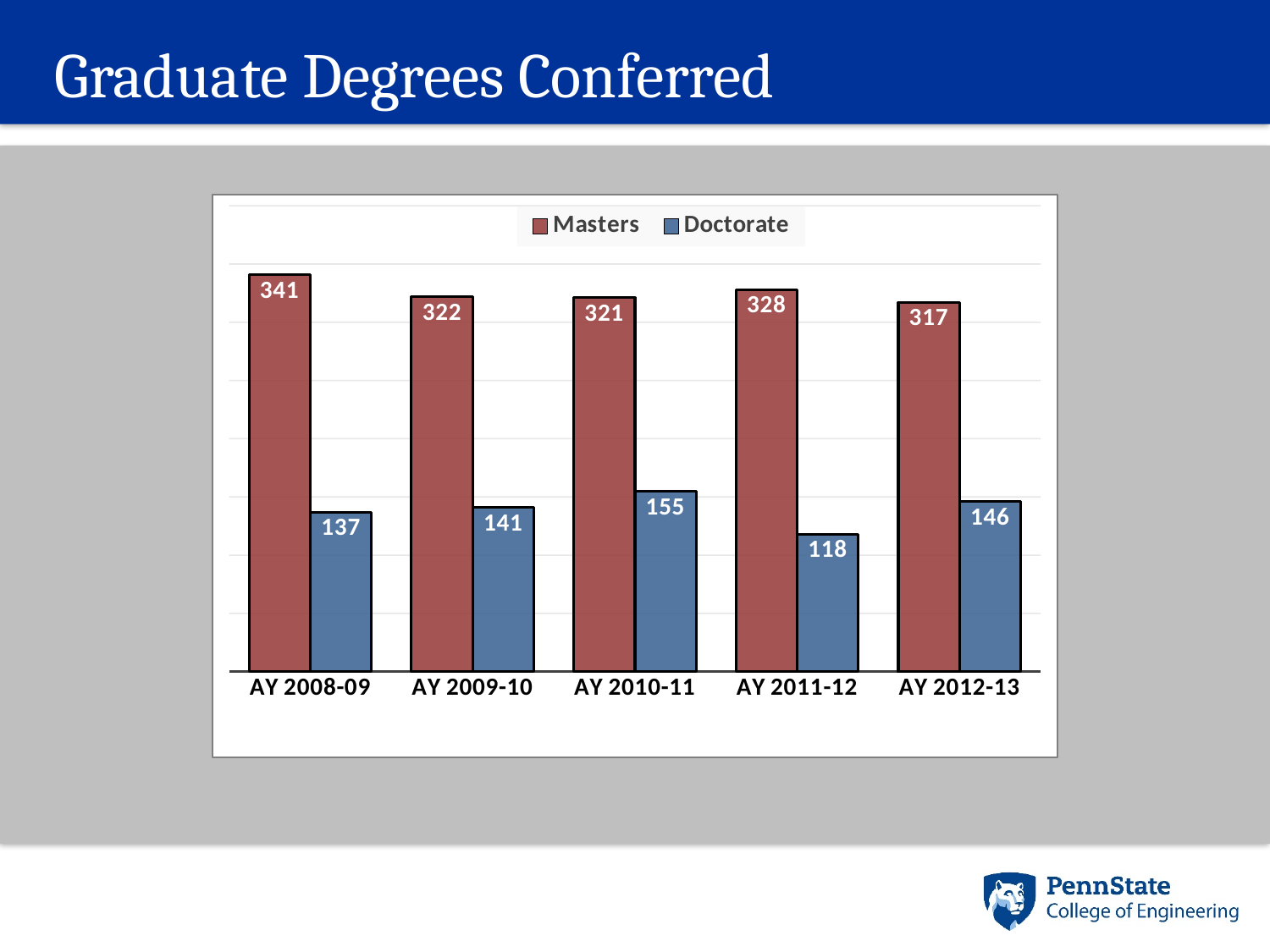
How many Doctorate degrees were conferred in AY 2011-12? 118 Which academic year has the highest Doctorate value? AY 2010-11 How many Masters degrees were conferred in AY 2008-09? 341 How many series does the legend list? 2 What is the difference between the Masters and Doctorate values in AY 2010-11? 166 What kind of chart is shown on the slide? Bar chart How many academic years are shown on the x axis? 5 What is the Doctorate value for AY 2012-13? 146 What is the title of the slide containing the chart? Graduate Degrees Conferred Which academic year has the lowest Doctorate value? AY 2011-12 Which academic year has the highest Masters value? AY 2008-09 Which is larger, the Doctorate value for AY 2009-10 or for AY 2012-13? AY 2012-13